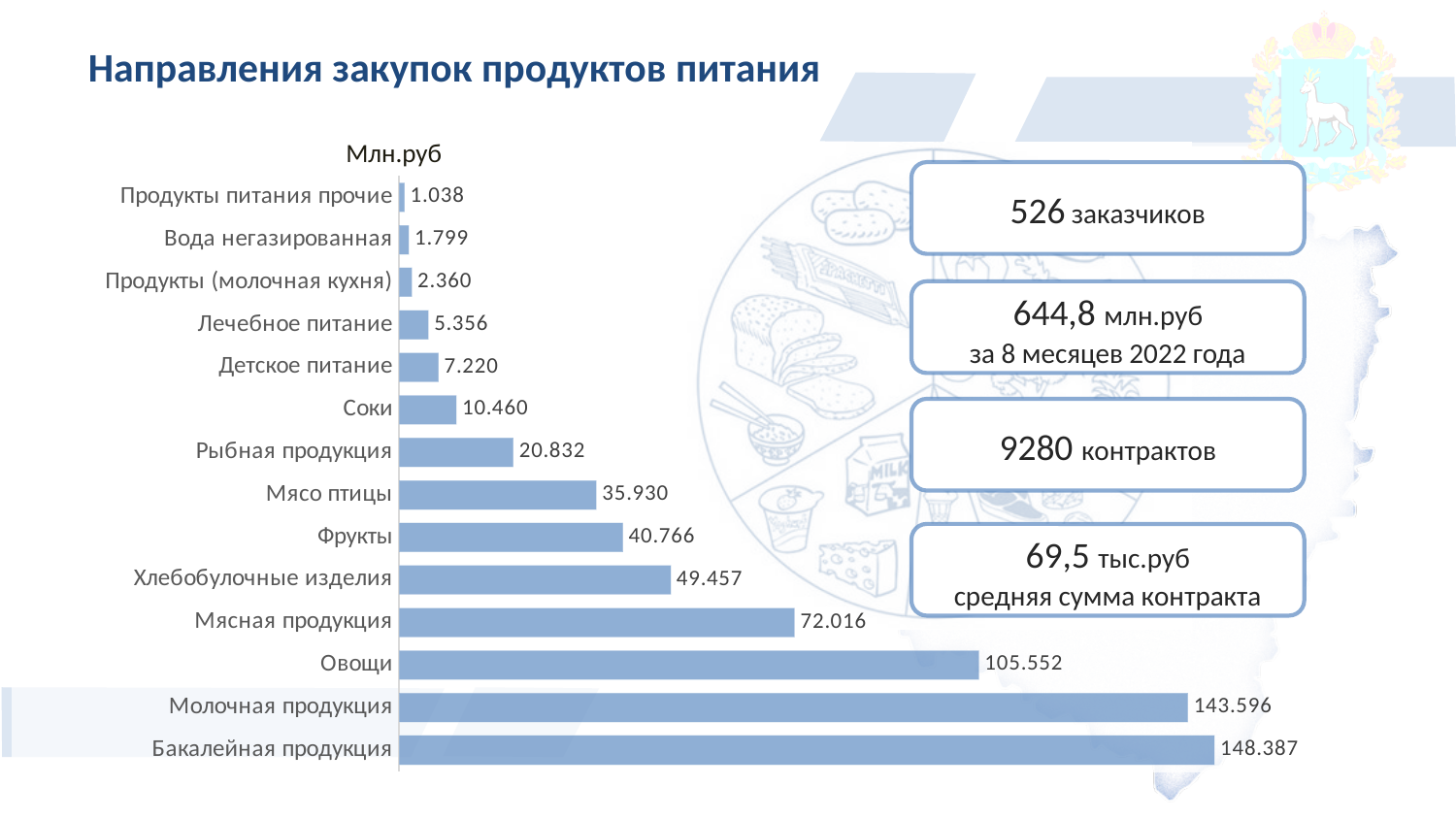
Which is larger, the value for Фрукты or the value for Мясо птицы? Фрукты What type of chart is shown on the slide? Bar chart What is the value for Хлебобулочные изделия? 49.457 What is the difference between the values for Овощи and Мясная продукция? 33.536 What is the value for Овощи? 105.552 What is the value for Соки? 10.460 How many categories are plotted in the chart? 14 What is the value for Молочная продукция? 143.596 Which category has the lowest value? Продукты питания прочие What unit label is shown above the chart's category axis? Млн.руб What is the difference between the values for Бакалейная продукция and Молочная продукция? 4.791 Which category has the highest value? Бакалейная продукция